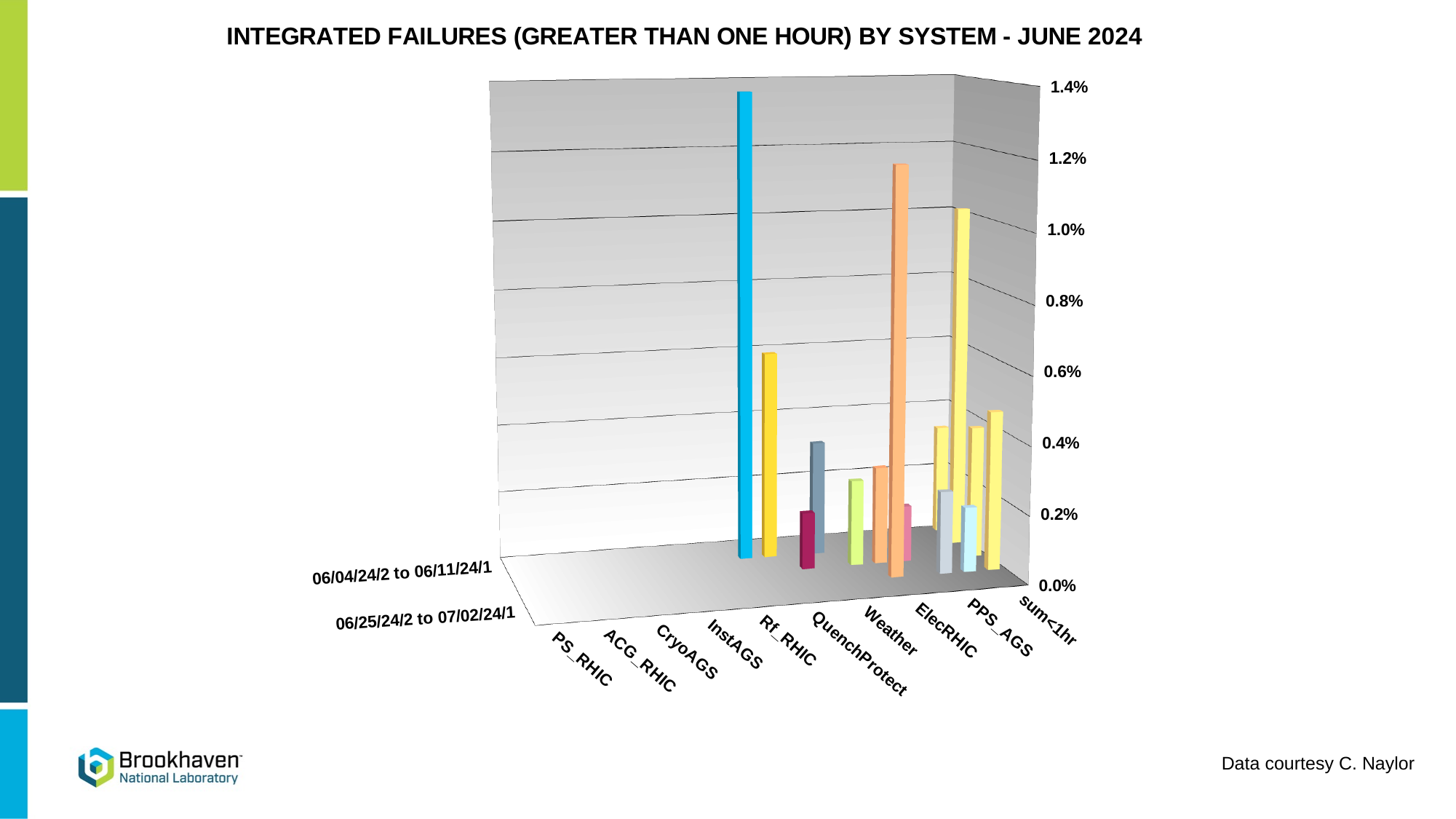
Is the highest value plotted in the chart greater or less than 1.2%? greater How many system categories are listed along the category axis of the chart? 10 What is the last category label on the category axis? sum<1hr What kind of chart is shown on the slide? bar chart What is the title of the chart? INTEGRATED FAILURES (GREATER THAN ONE HOUR) BY SYSTEM - JUNE 2024 What is the first category label on the category axis? PS_RHIC What is the highest value shown on the vertical axis of the chart? 1.4%